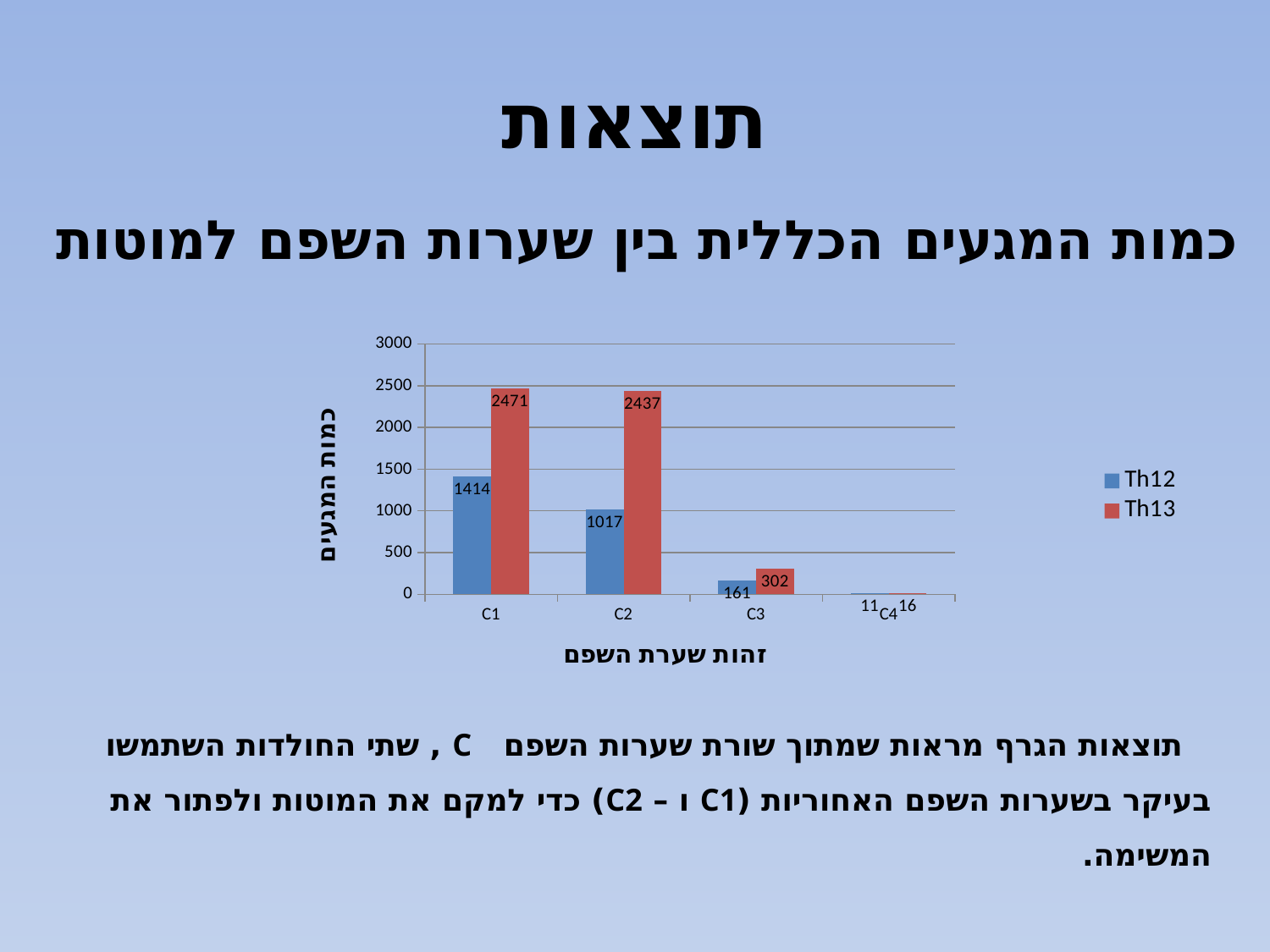
Which category has the lowest Th12 value? C4 Which category has the highest Th13 value? C1 Which is larger at C2: the Th12 value or the Th13 value? Th13 How many categories are shown on the x axis? 4 What is the value for Th13 at C1? 2471 What is the value for Th12 at C3? 161 What is the value for Th13 at C4? 16 How many series does the legend list? 2 Is the Th13 value at C2 greater or less than 2000? greater What kind of chart is shown on the slide? bar chart What is the difference between the Th13 and Th12 values at C1? 1057 What is the value for Th12 at C2? 1017